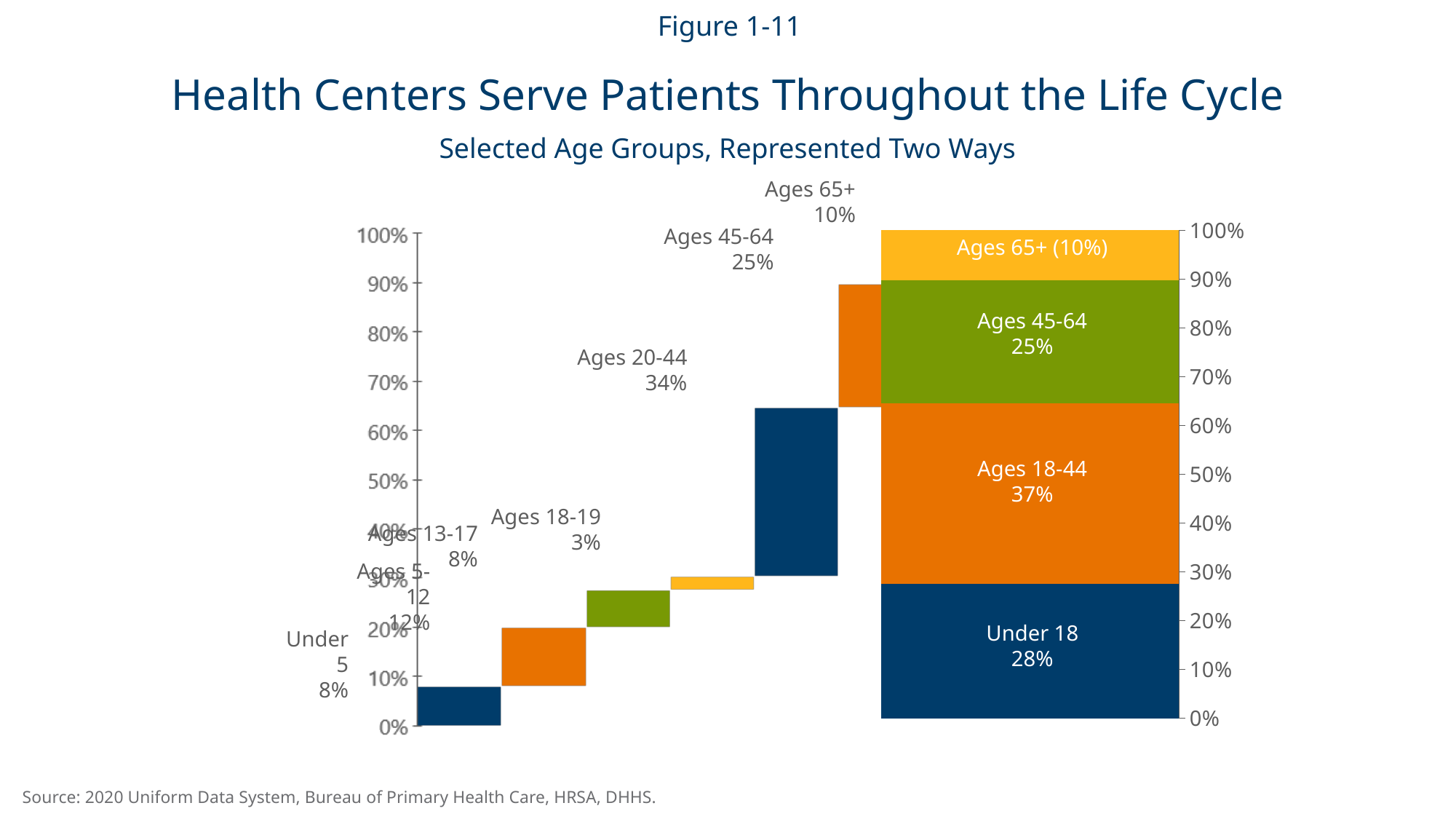
In the stacked bar on the right, what percentage is shown for Under 18? 28% In the left-hand waterfall portion of the chart, what percentage is shown for Ages 20-44? 34% In the left-hand waterfall portion of the chart, what percentage is shown for Ages 18-19? 3% In the stacked bar on the right, which age group segment is the smallest? Ages 65+ What is the title of the chart? Health Centers Serve Patients Throughout the Life Cycle How many age groups are shown in the left-hand waterfall portion of the chart? 7 In the stacked bar on the right, how many percentage points larger is Ages 18-44 than Under 18? 9 What is the total of the four segments in the stacked bar on the right? 100% In the stacked bar on the right, what percentage is shown for Ages 18-44? 37% In the left-hand waterfall portion of the chart, which is larger: Ages 5-12 or Ages 13-17? Ages 5-12 In the left-hand waterfall portion of the chart, which age group has the smallest percentage? Ages 18-19 In the left-hand waterfall portion of the chart, which age group has the largest percentage? Ages 20-44